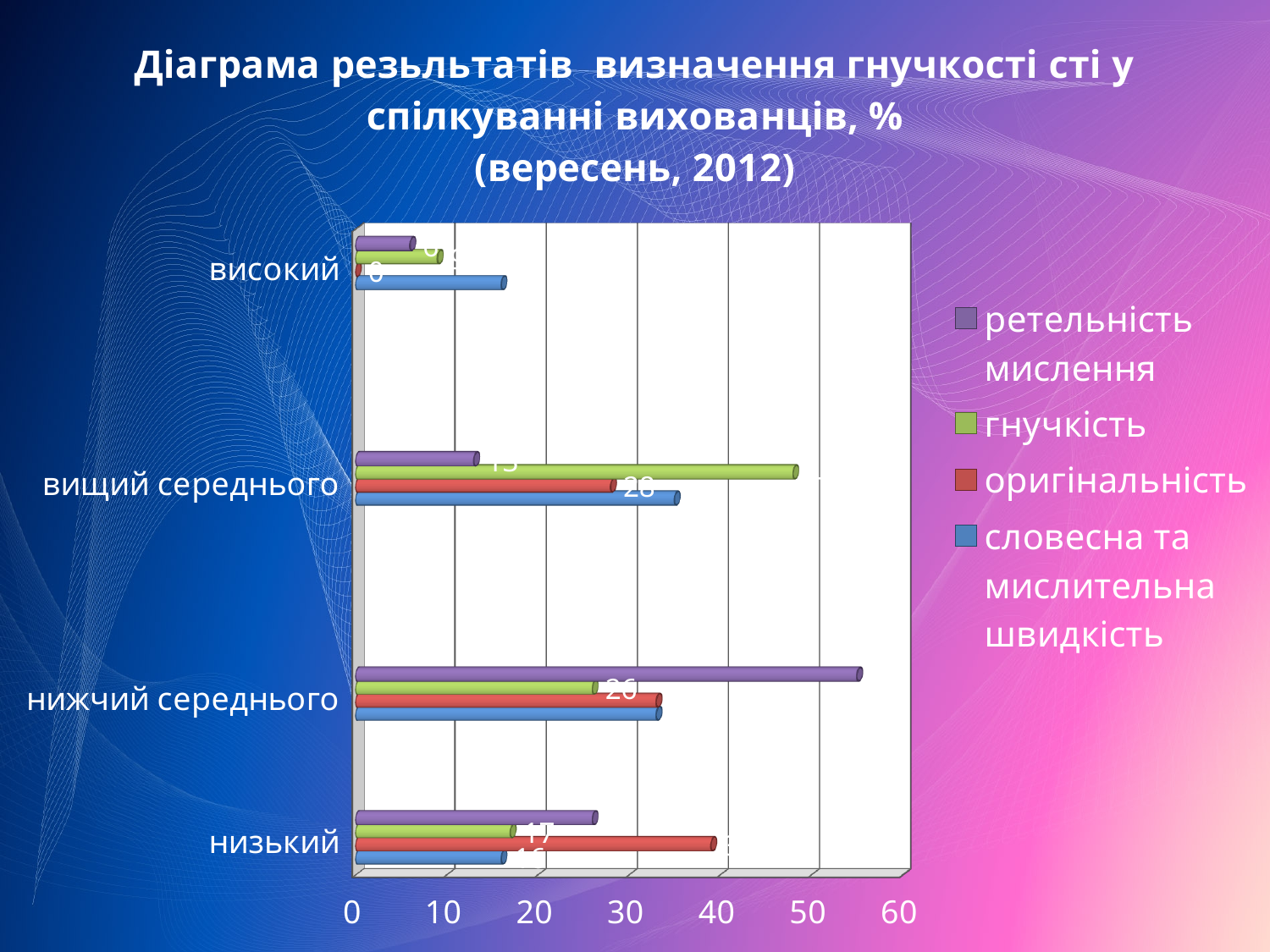
Is the value for словесна та мислительна швидкість in the category високий greater or less than 20? less Which series has the highest value in the category вищий середнього? гнучкість Which series has the highest value in the category нижчий середнього? ретельність мислення How many series does the legend list? 4 Is the value for ретельність мислення in the category нижчий середнього greater or less than 50? greater In the category низький, which is larger: оригінальність or гнучкість? оригінальність Which series has the lowest value in the category високий? оригінальність Is the value for гнучкість in the category вищий середнього greater or less than 40? greater How many categories are shown on the vertical axis of the chart? 4 Which series has the highest value in the category низький? оригінальність What kind of chart is shown on the slide? bar chart